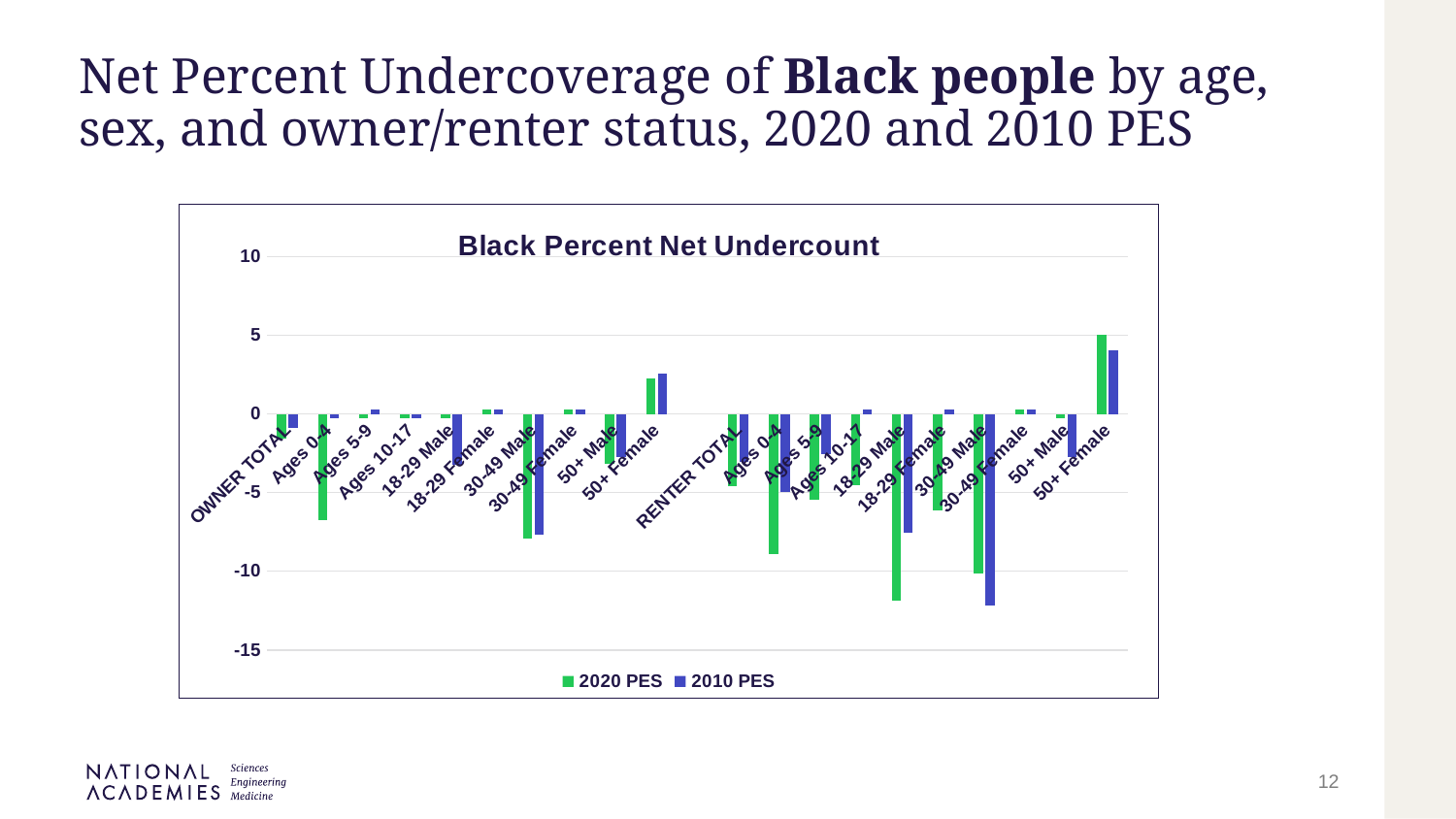
Is the 2020 PES value for renter 18-29 Male greater or less than -10? less What is the title printed inside the chart area? Black Percent Net Undercount How many categories are shown along the x axis of the chart? 20 Which category has the lowest 2010 PES value in the chart? 30-49 Male (renter) For 50+ Female in 2020 PES, which is larger: the owner value or the renter value? renter Is the 2010 PES value for renter 30-49 Male greater or less than -10? less What kind of chart is shown on the slide? bar chart Which category has the highest 2020 PES value in the chart? 50+ Female (renter) Is the 2020 PES value for renter Ages 0-4 greater or less than -5? less Which colour represents the 2020 PES series in the chart? green How many series does the chart legend list? 2